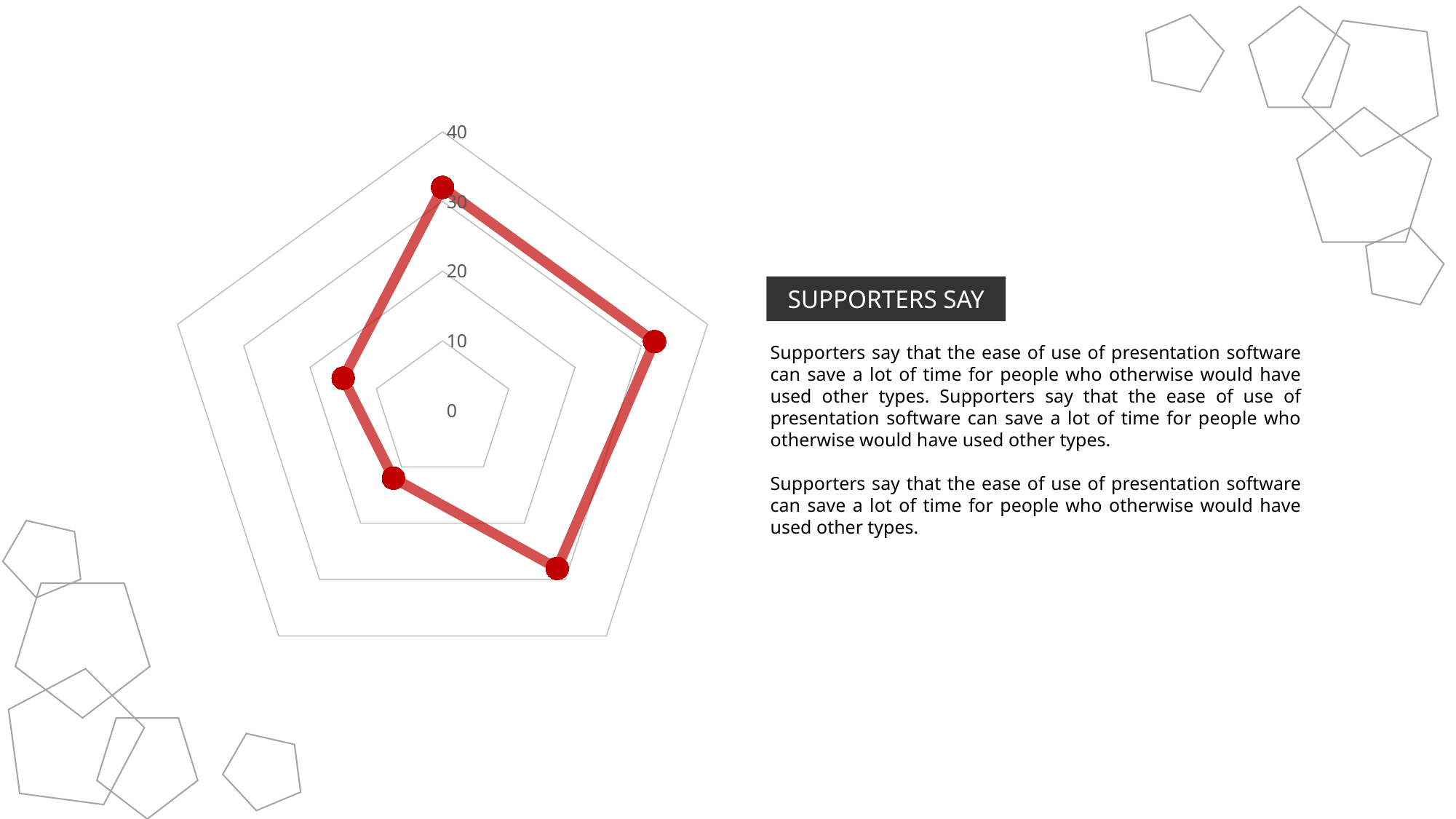
What colour is the data series plotted on the radar chart? red Is the value of the bottom-left point on the radar chart greater or less than 20? less Is the value of the leftmost point on the radar chart greater or less than 10? greater Is the value of the rightmost point on the radar chart greater or less than 20? greater How many data points are plotted on the radar chart? 5 What is the highest value labelled on the radar chart's axis? 40 What kind of chart is shown on the slide? radar chart